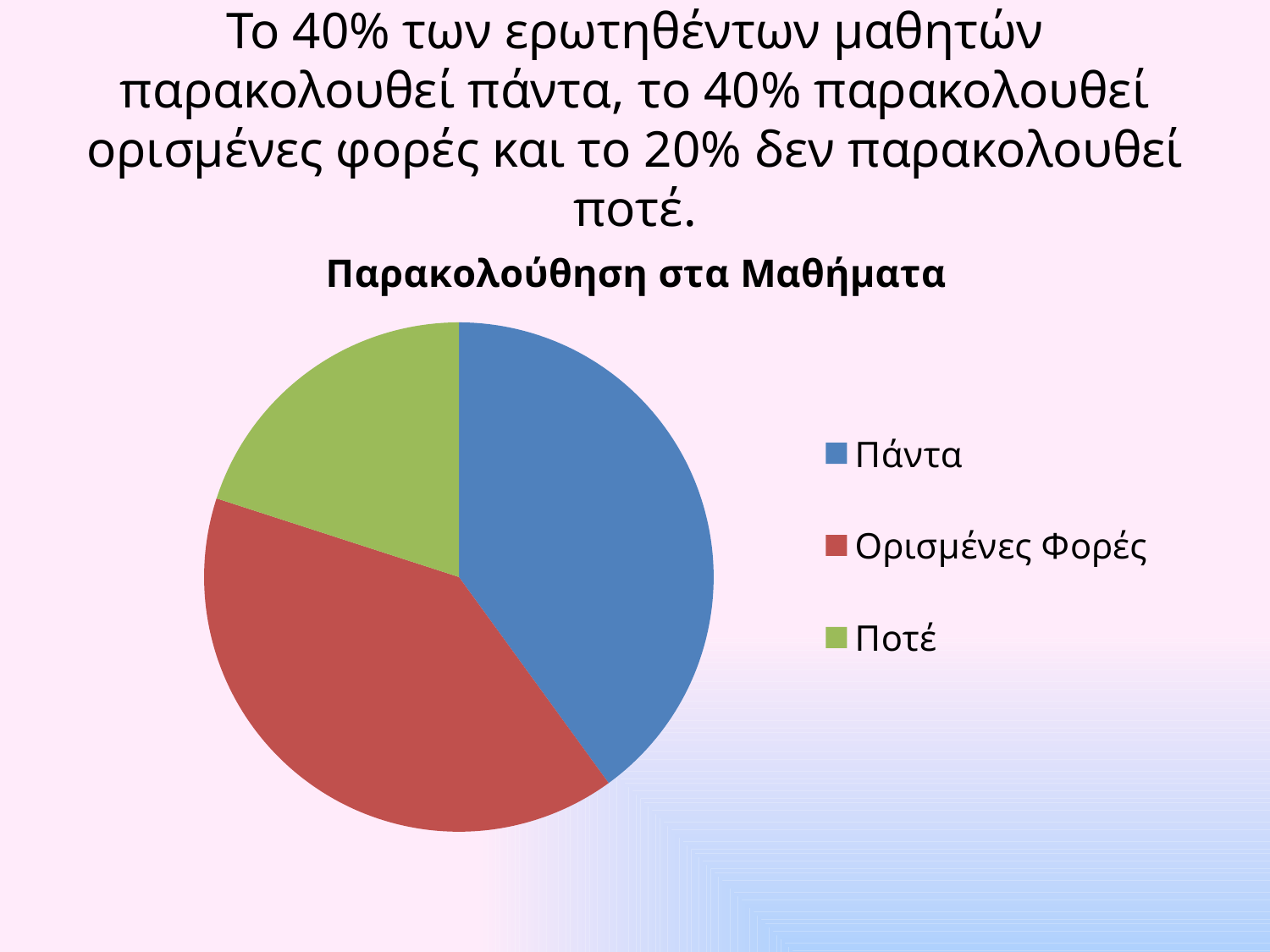
What kind of chart is shown on the slide? pie chart What share of the pie does Ορισμένες Φορές represent? 40% Which category has the smallest slice of the pie? Ποτέ How many entries does the legend list? 3 Which slice is larger, Ορισμένες Φορές or Ποτέ? Ορισμένες Φορές What share of the pie does Ποτέ represent? 20% What colour is the slice for Ποτέ? green What share of the pie does Πάντα represent? 40% How many slices does the pie chart have? 3 What is the difference between the share for Πάντα and the share for Ποτέ? 20% What is the title of the chart? Παρακολούθηση στα Μαθήματα Which slice is larger, Πάντα or Ποτέ? Πάντα